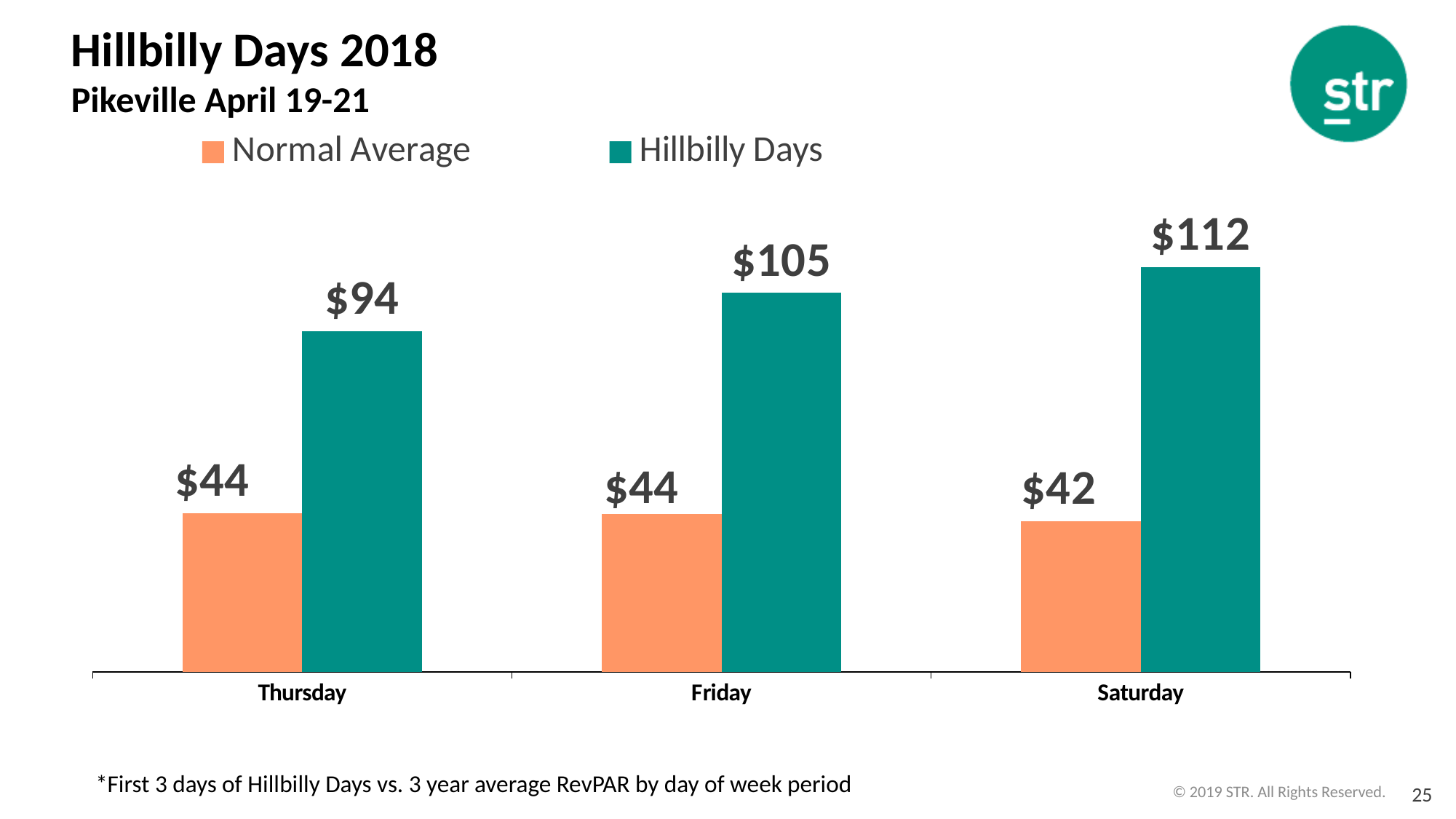
Do the Hillbilly Days values rise or fall from Thursday to Saturday? Rise How many days are shown on the x axis? 3 What kind of chart is shown on the slide? Bar chart Which day has the lowest Normal Average value? Saturday What is the Normal Average value for Saturday? $42 Which is larger, the Hillbilly Days value for Thursday or the Hillbilly Days value for Friday? Friday What is the difference between the Hillbilly Days values for Friday and Thursday? $11 Which day has the highest Hillbilly Days value? Saturday What is the Hillbilly Days value for Thursday? $94 What is the difference between the Hillbilly Days and Normal Average values for Saturday? $70 What is the Hillbilly Days value for Friday? $105 How many series does the legend list? 2